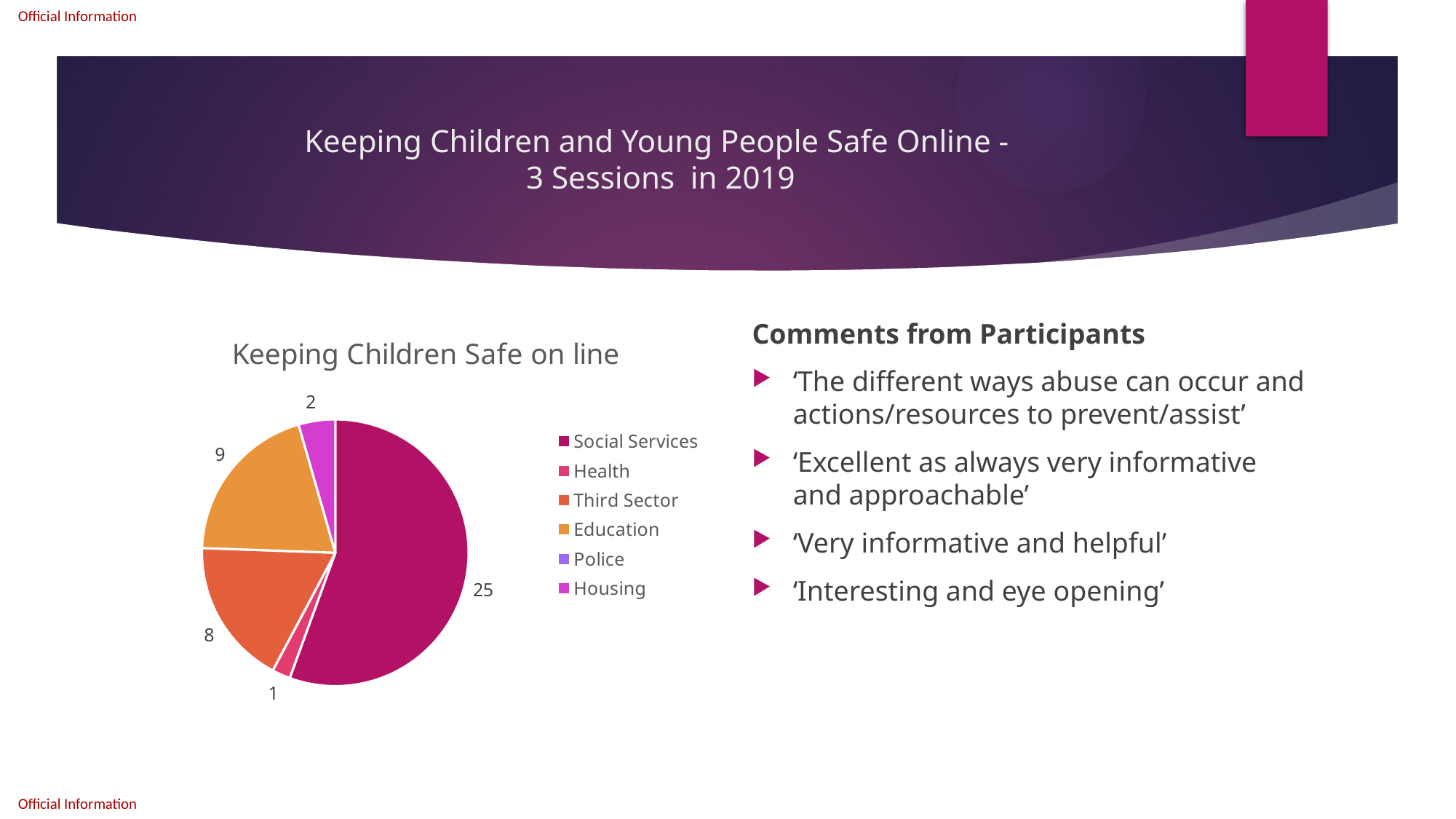
What is the difference between the values for Third Sector and Housing? 6 What is the value for Health in the pie chart? 1 What is the difference between the values for Social Services and Education? 16 Which has the larger value, Education or Third Sector? Education What type of chart is shown on the slide? Pie chart What is the value for Education in the pie chart? 9 How many categories does the chart legend list? 6 Which category has the largest slice of the pie chart? Social Services What is the value for Social Services in the pie chart? 25 What is the value for Third Sector in the pie chart? 8 What is the value for Housing in the pie chart? 2 What is the title of the chart? Keeping Children Safe on line